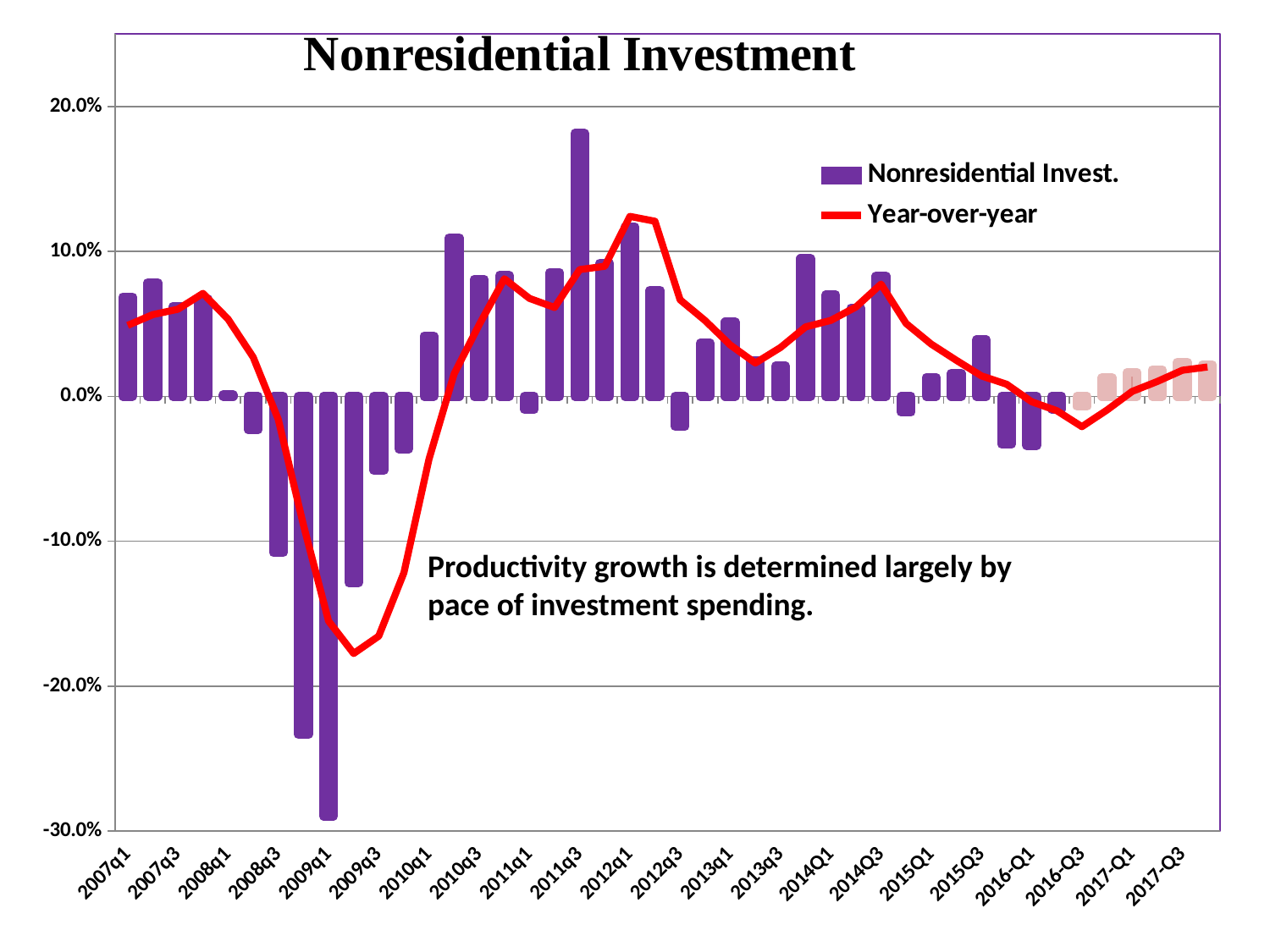
Which has the larger Nonresidential Invest. bar, 2007q3 or 2008q1? 2007q3 Do the Nonresidential Invest. bars rise or fall from 2007q3 to 2009q1? fall Which quarter has the highest Nonresidential Invest. bar? 2011q3 Is the Nonresidential Invest. value for 2011q3 greater or less than 10.0%? greater Is the Nonresidential Invest. value for 2009q1 greater or less than -20.0%? less Which quarter has the lowest Nonresidential Invest. bar? 2009q1 Is the Nonresidential Invest. value for 2008q3 greater or less than -10.0%? less What is the title of the chart? Nonresidential Investment What kind of chart is shown on the slide? A bar chart combined with a line How many series does the legend list? 2 Which series is drawn as a red line? Year-over-year